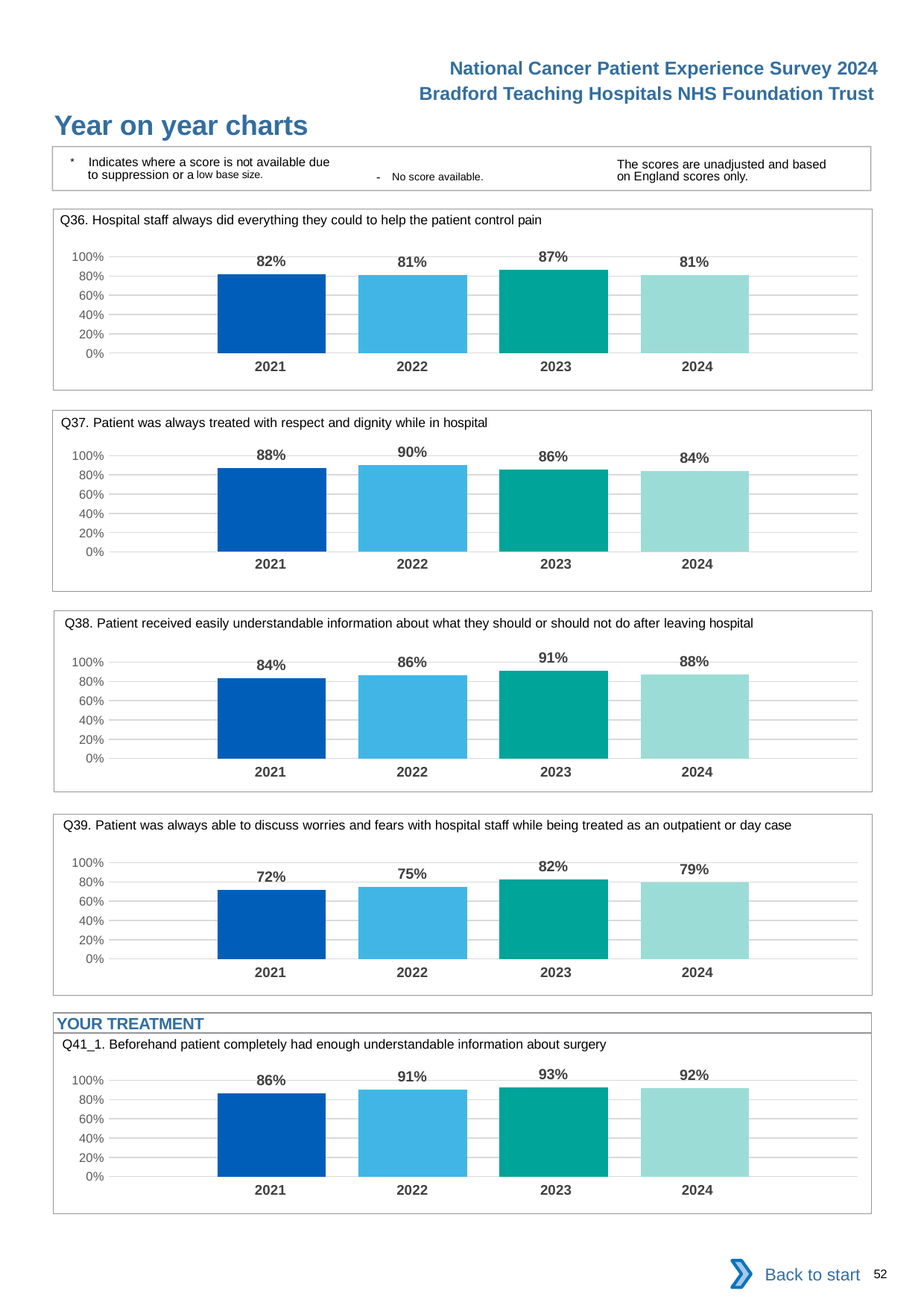
In the Q38 chart (understandable information after leaving hospital), what is the value for 2021? 84% In the Q41_1 chart (understandable information about surgery), what is the value for 2024? 92% In the Q37 chart (treated with respect and dignity), which year has the highest value? 2022 In the Q41_1 chart (understandable information about surgery), which is larger, the 2021 value or the 2022 value? 2022 In the Q39 chart (discuss worries and fears as an outpatient), which year has the lowest value? 2021 In the Q39 chart (discuss worries and fears as an outpatient), what is the difference between the 2023 and 2021 values? 10% In the Q36 chart (hospital staff helped control pain), is the value for 2022 greater or less than 60%? greater How many years are shown in the Q36 chart (hospital staff helped control pain)? 4 What type of chart is the Q39 chart (discuss worries and fears as an outpatient)? Bar chart In the Q38 chart (understandable information after leaving hospital), which year has the highest value? 2023 In the Q37 chart (treated with respect and dignity), what is the difference between the 2022 and 2024 values? 6% In the Q36 chart (hospital staff helped control pain), what is the value for 2023? 87%